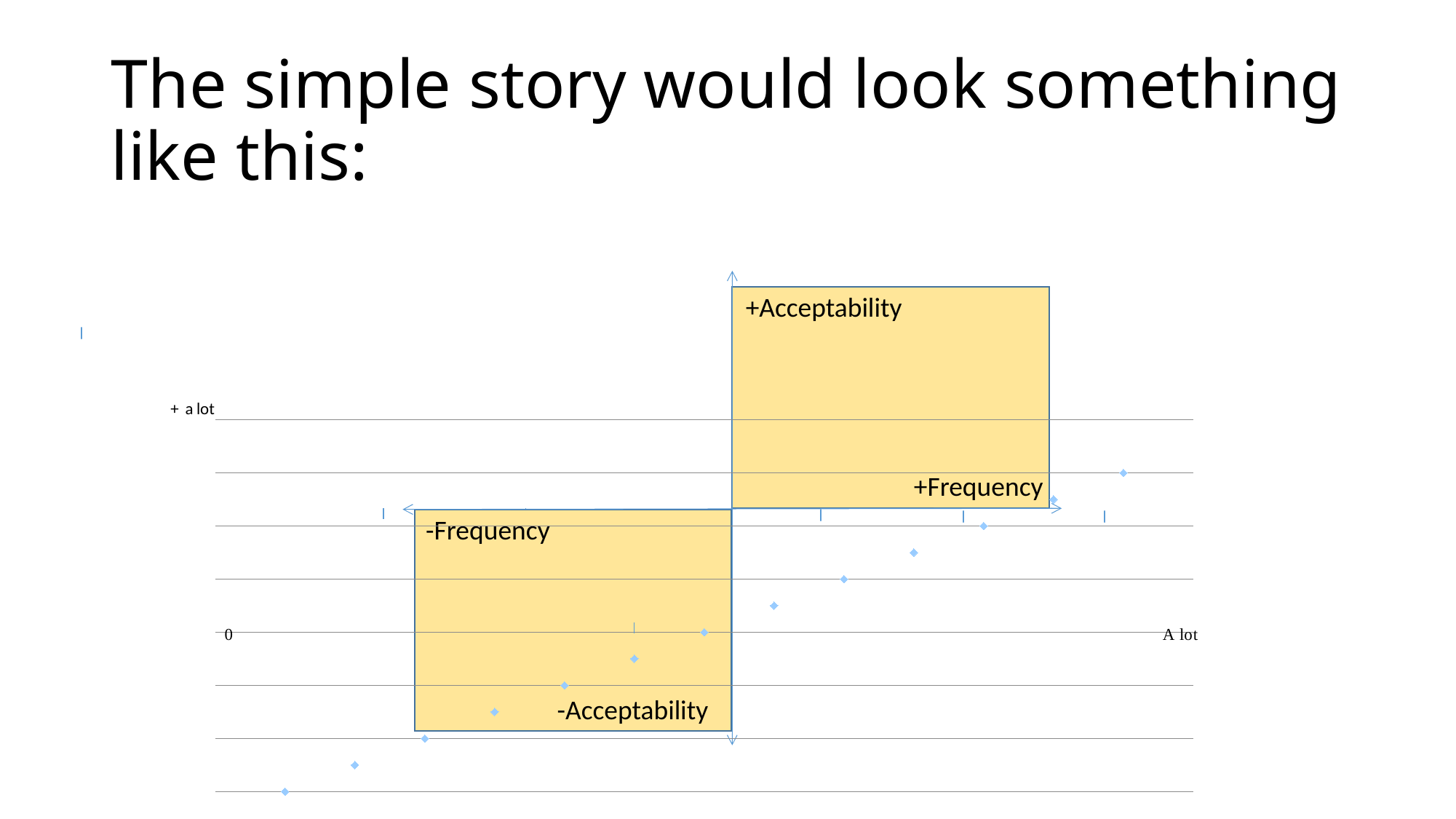
What label appears at the right end of the x axis? A lot What label appears at the top of the y axis? + a lot How many data points are plotted on the chart? 13 Do the plotted points rise or fall as you move from left to right along the x axis? rise What kind of chart is shown on the slide? scatter chart